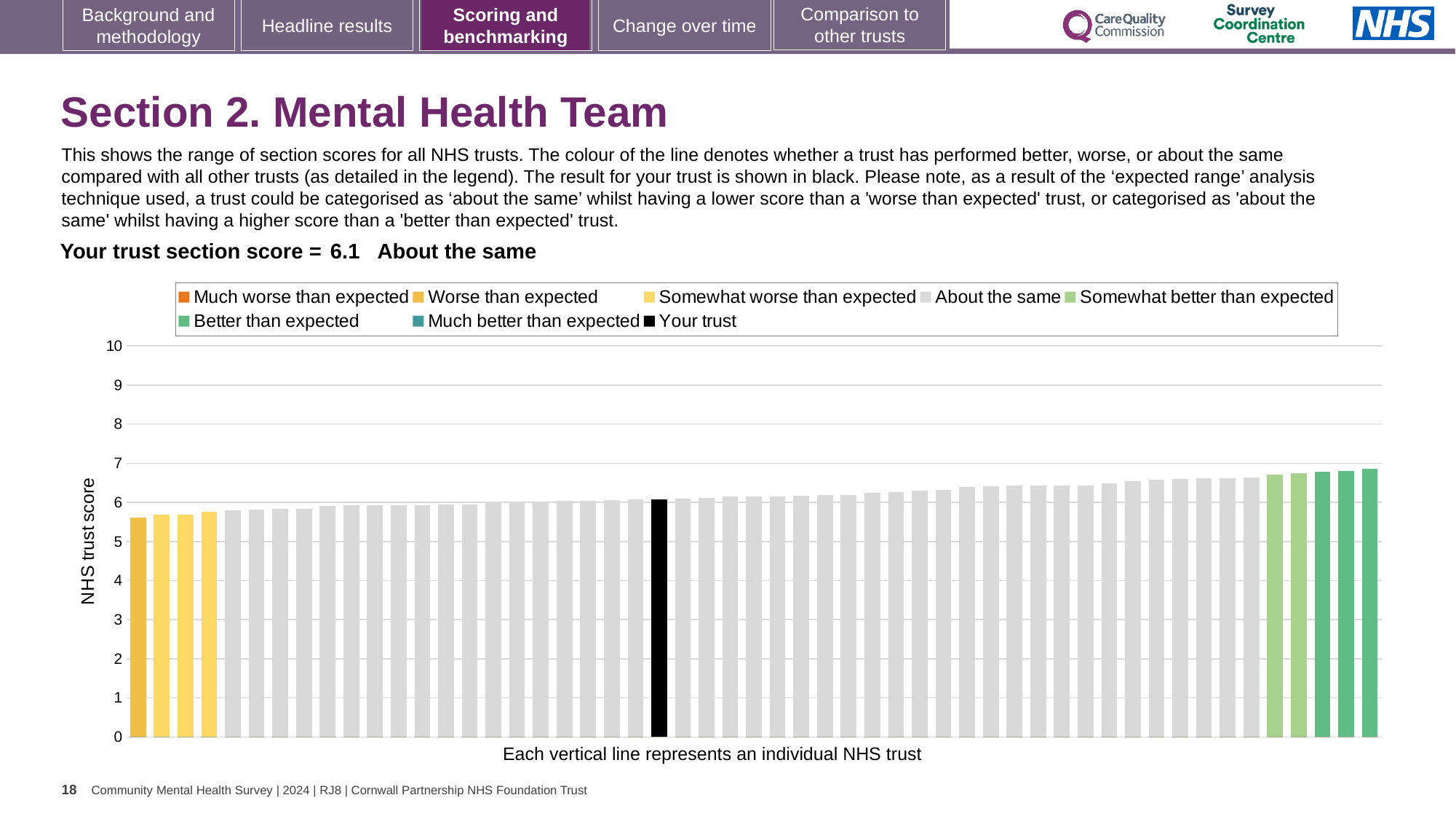
How many entries does the chart legend list? 8 What is the maximum value shown on the y axis? 10 What is the trust's section score shown on the slide? 6.1 Is the value of the highest bar in the chart greater or less than 6? greater What kind of chart is shown on the slide? bar chart What is the label on the y axis of the chart? NHS trust score Which category is the trust's section score placed in? About the same Is the value of the highest bar in the chart greater or less than 7? less Do the bar values rise or fall from left to right along the x axis? rise Is the value of the lowest bar in the chart greater or less than 6? less What colour is the bar representing your trust? black